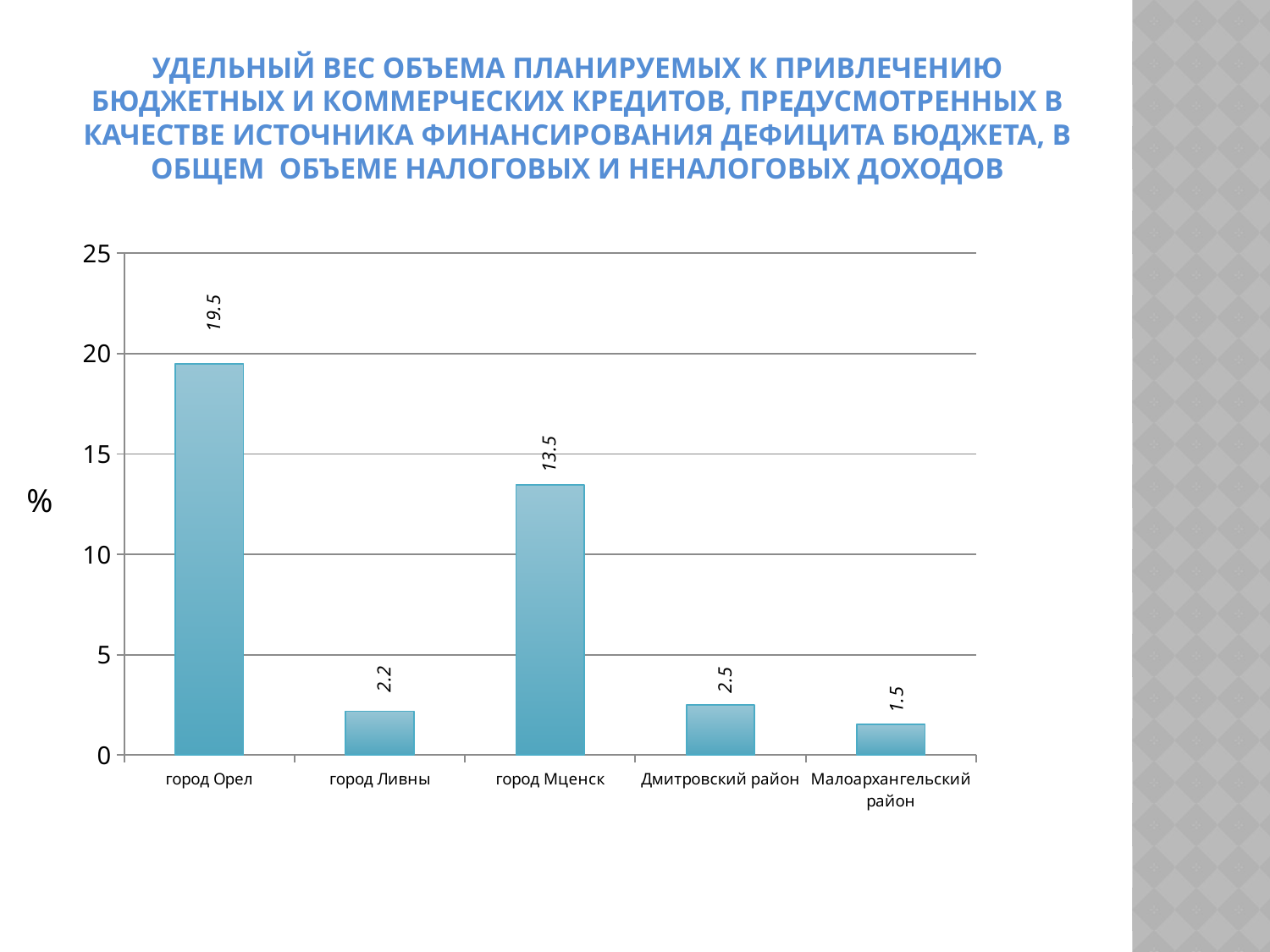
Which category has the highest value? город Орел What is the value for город Орел? 19.5 What is the value for Малоархангельский район? 1.5 Which category has the lowest value? Малоархангельский район Is the value for город Мценск greater or less than 15? less What is the difference between the values for город Орел and город Мценск? 6 What kind of chart is shown on the slide? bar chart What is the difference between the values for Дмитровский район and город Ливны? 0.3 How many categories are shown on the x axis? 5 What unit label is shown on the vertical axis? % Which is larger, the value for город Ливны or the value for Дмитровский район? Дмитровский район What is the value for город Мценск? 13.5